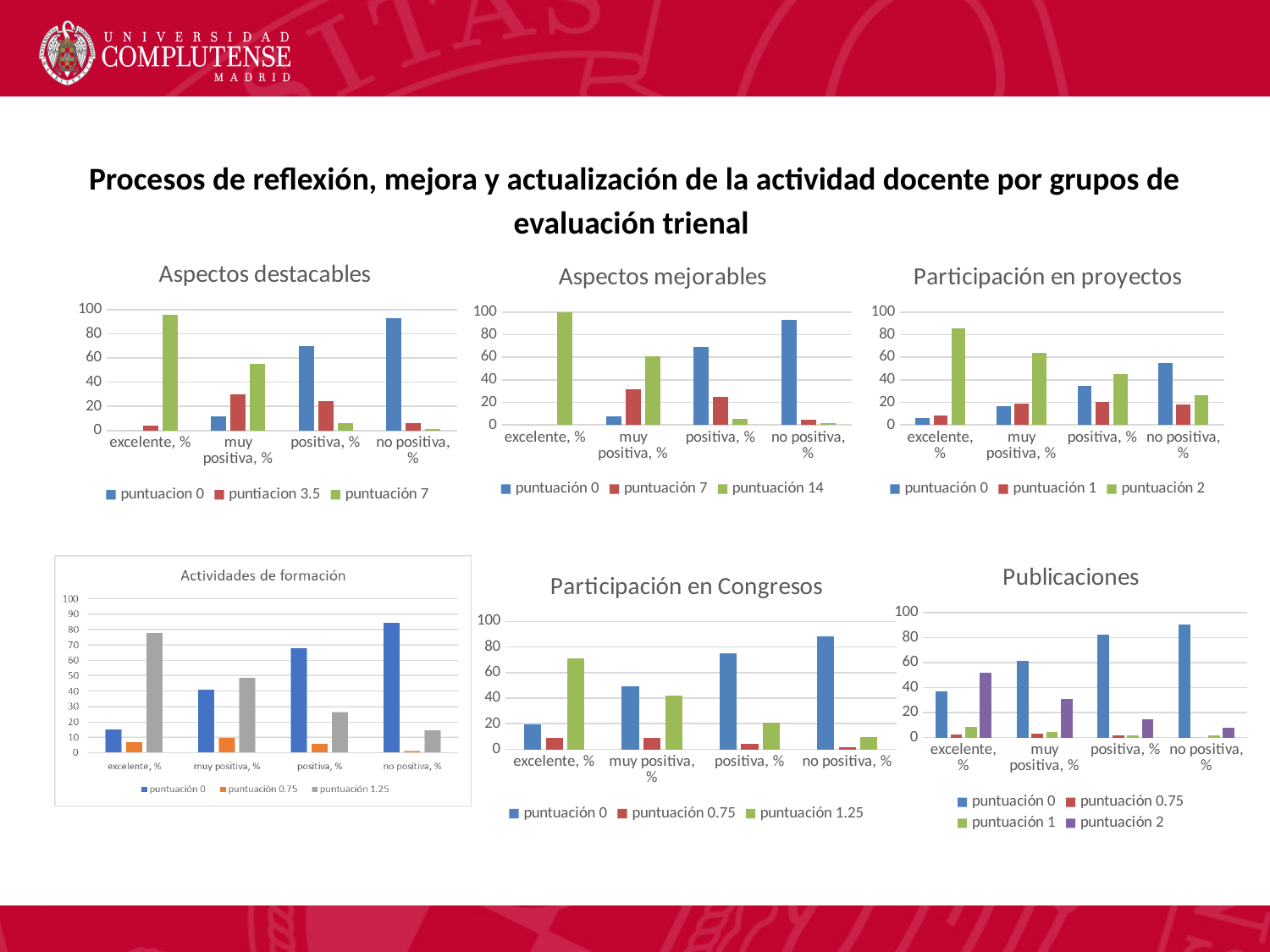
In the 'Actividades de formación' chart, do the values of 'puntuación 1.25' rise or fall from 'excelente, %' to 'no positiva, %'? fall In the 'Participación en Congresos' chart, do the values of 'puntuación 0' rise or fall from 'excelente, %' to 'no positiva, %'? rise In the 'Participación en proyectos' chart, is the value of 'puntuación 2' for 'excelente, %' greater or less than 60? greater In the 'Aspectos destacables' chart, for 'muy positiva, %', which is larger: 'puntiacion 3.5' or 'puntuación 7'? puntuación 7 How many charts are shown on the slide? 6 In the 'Participación en Congresos' chart, which category has the highest value for 'puntuación 0'? no positiva, % What kind of chart is 'Aspectos mejorables'? bar chart In the 'Aspectos destacables' chart, is the value of 'puntuación 7' for 'excelente, %' greater or less than 80? greater In the 'Participación en Congresos' chart, how many categories are shown on the x axis? 4 In the 'Publicaciones' chart, how many series does the legend list? 4 In the 'Aspectos mejorables' chart, which category has the highest value for 'puntuación 14'? excelente, % In the 'Aspectos destacables' chart, how many series does the legend list? 3